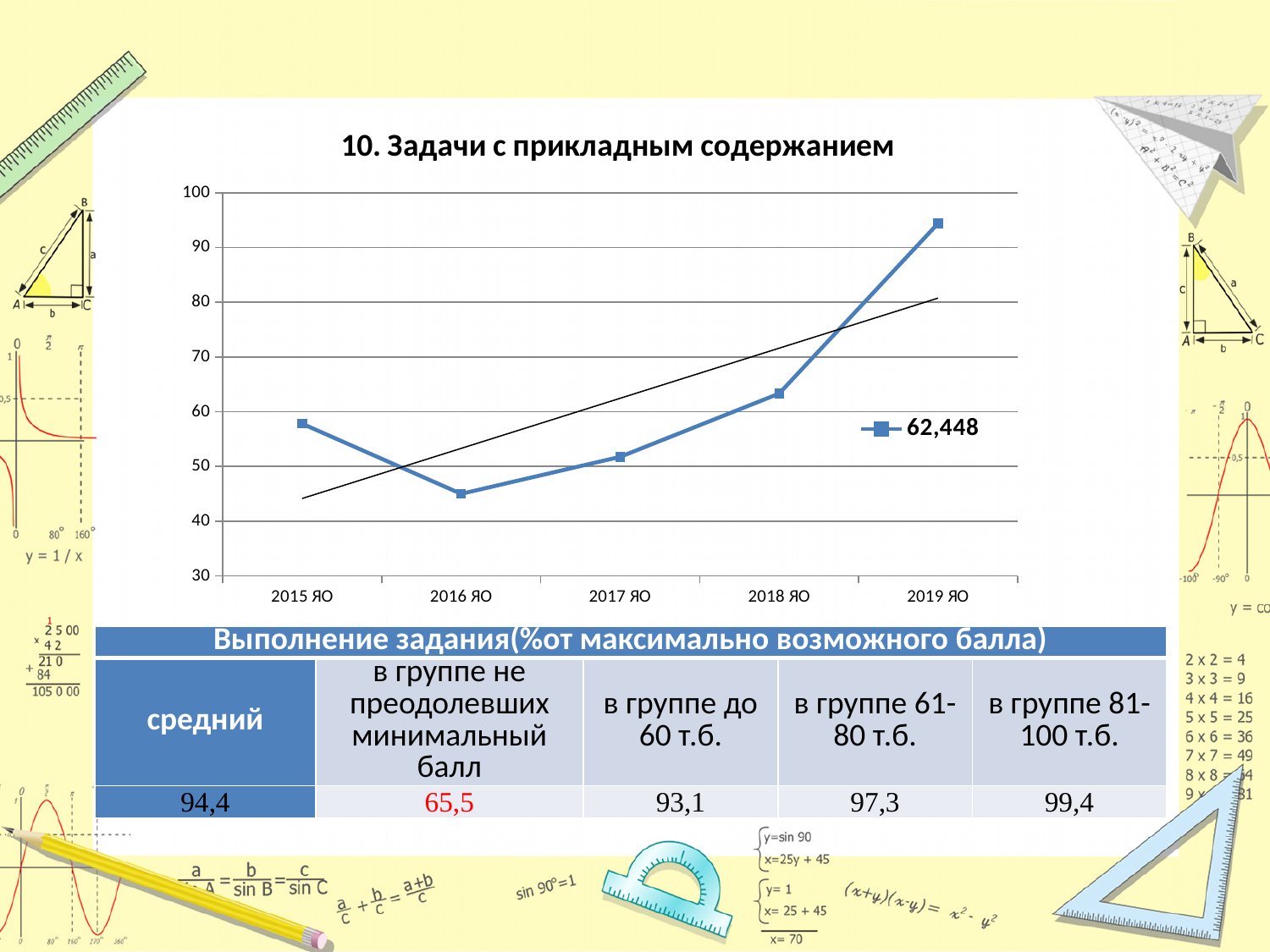
What is the legend entry for the plotted series? 62,448 What kind of chart is shown on the slide? line chart Is the value for 2016 ЯО greater or less than 50? less Which year has the highest value on the chart? 2019 ЯО Do the values rise or fall from 2016 ЯО to 2019 ЯО? rise Is the value for 2015 ЯО greater or less than 50? greater Which year has the lowest value on the chart? 2016 ЯО How many points are plotted along the x axis of the chart? 5 Which is larger, the value for 2015 ЯО or the value for 2016 ЯО? 2015 ЯО How many series does the chart legend list? 1 Is the value for 2019 ЯО greater or less than 90? greater What is the title of the chart? 10. Задачи с прикладным содержанием